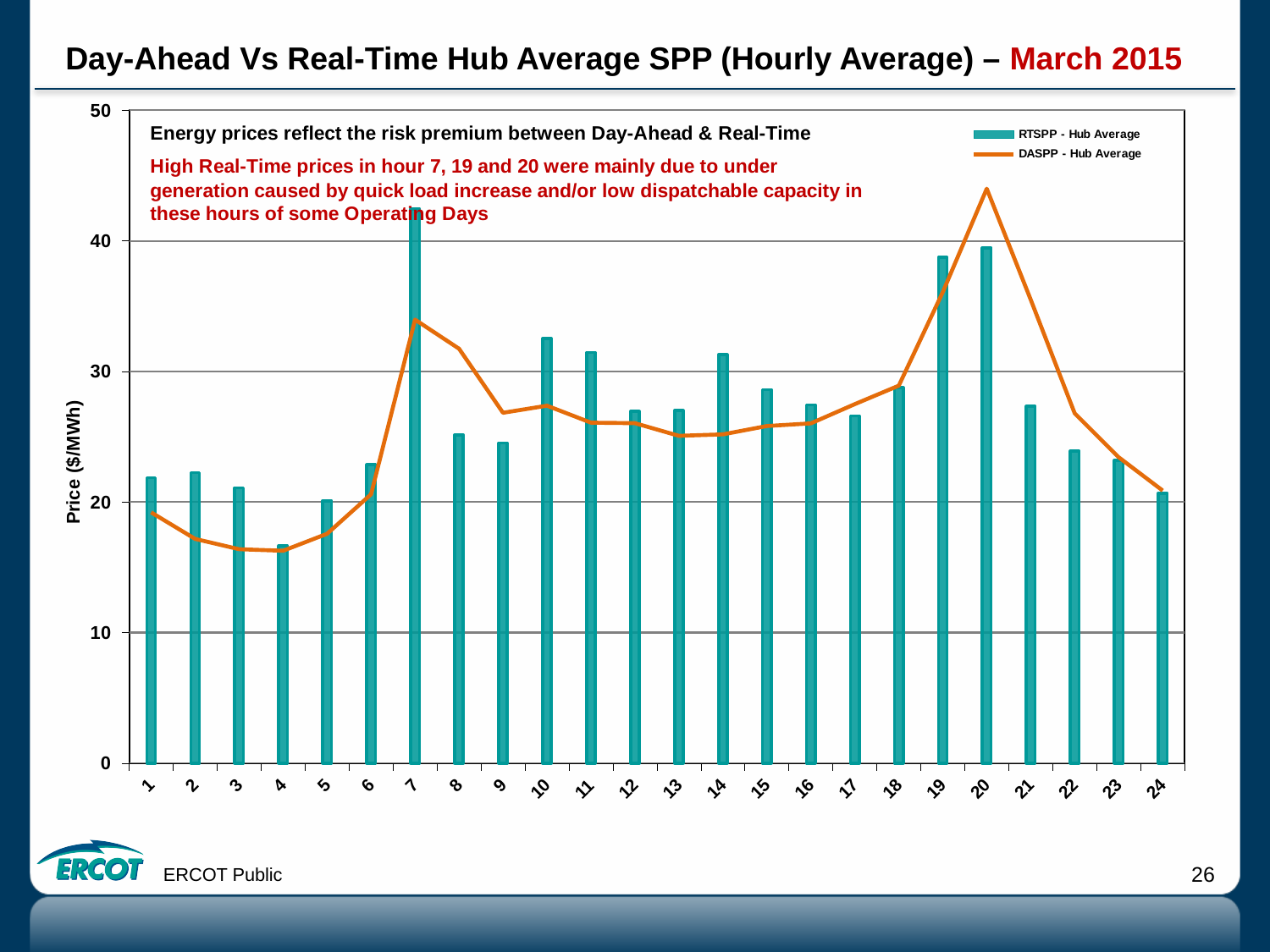
Is the DASPP - Hub Average value for hour 13 greater or less than 30? less In hour 20, which is larger: the RTSPP - Hub Average or the DASPP - Hub Average? DASPP - Hub Average Is the RTSPP - Hub Average value for hour 4 greater or less than 20? less What is the y-axis label of the chart? Price ($/MWh) In which hour is the RTSPP - Hub Average bar the highest? 7 How many series does the chart legend list? 2 In which hour is the RTSPP - Hub Average bar the lowest? 4 In which hour does the DASPP - Hub Average line reach its highest value? 20 Is the RTSPP - Hub Average value for hour 7 greater or less than 40? greater What kind of chart is shown on the slide? Combined bar and line chart How many hours (categories) are shown on the x axis of the chart? 24 Which series is drawn as bars in the chart? RTSPP - Hub Average